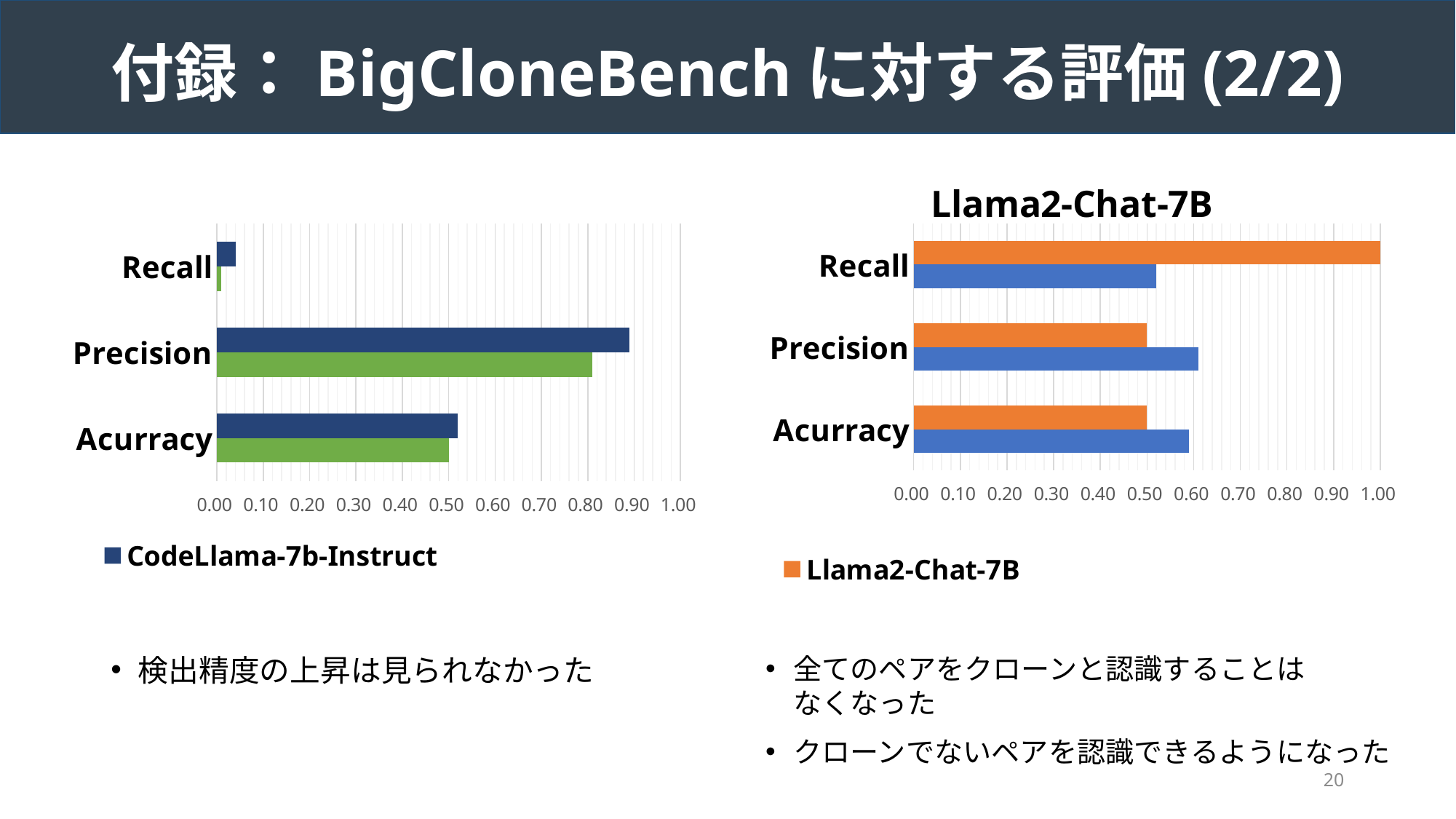
How many categories does the left chart show? 3 What kind of chart is the left chart on the slide? bar chart In the left chart, which category has the highest value for CodeLlama-7b-Instruct? Precision In the right chart titled Llama2-Chat-7B, which category has the highest value for Llama2-Chat-7B? Recall In the left chart, is the CodeLlama-7b-Instruct value for Recall greater or less than 0.10? less In the left chart, which category has the lowest value for CodeLlama-7b-Instruct? Recall How many series does the legend of the right chart list? 1 What is the title of the right chart? Llama2-Chat-7B In the left chart, is the CodeLlama-7b-Instruct value for Precision greater or less than 0.80? greater In the right chart titled Llama2-Chat-7B, what is the Llama2-Chat-7B value for Recall? 1.00 In the right chart titled Llama2-Chat-7B, is the Llama2-Chat-7B value for Precision greater or less than 0.60? less In the right chart titled Llama2-Chat-7B, which is larger for Llama2-Chat-7B: Recall or Acurracy? Recall